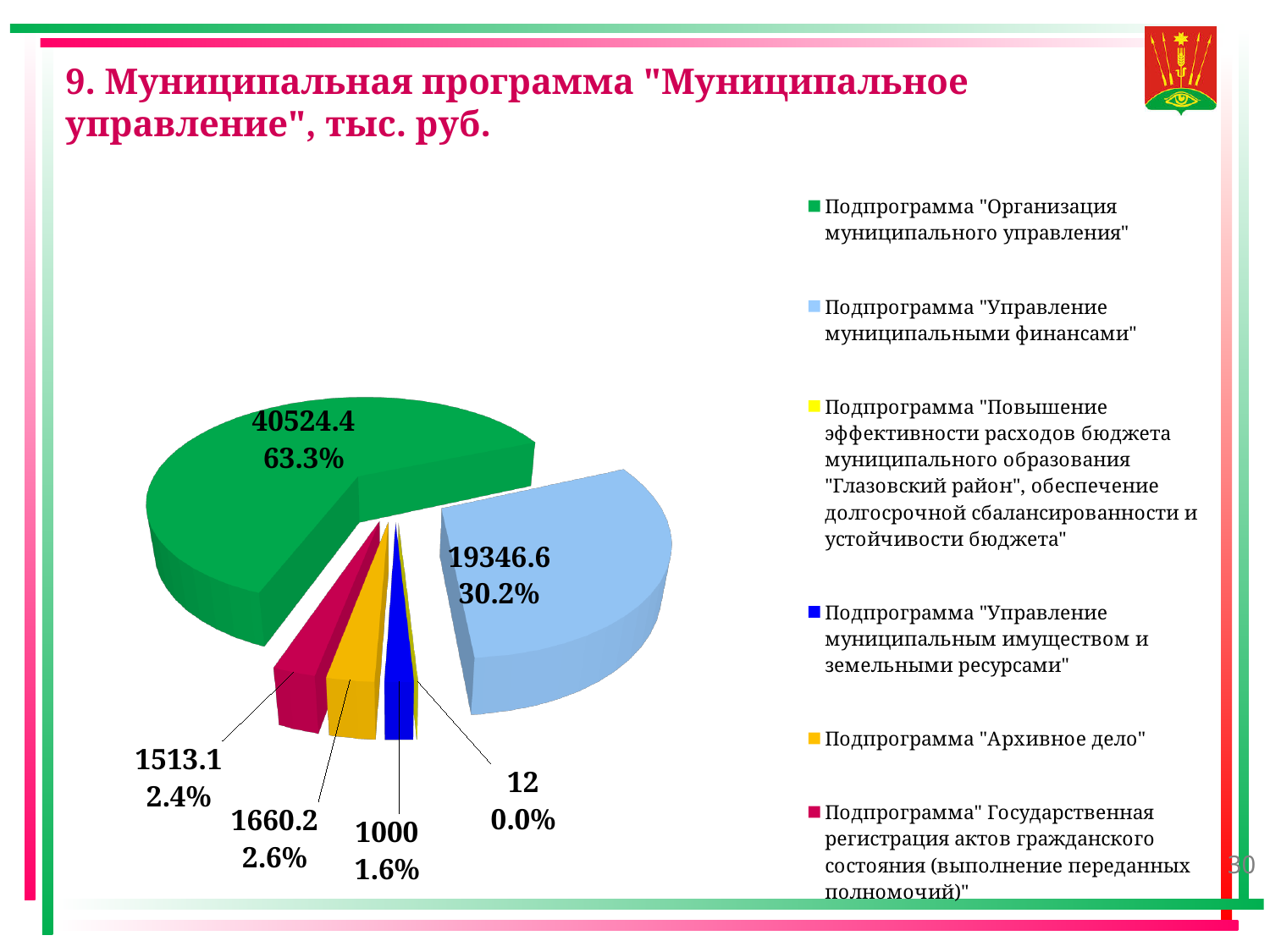
How many slices does the pie chart have? 6 Which subprogram has the smallest slice of the pie? Подпрограмма "Повышение эффективности расходов бюджета муниципального образования "Глазовский район", обеспечение долгосрочной сбалансированности и устойчивости бюджета" What is the difference between the values for "Организация муниципального управления" and "Управление муниципальными финансами"? 21177.8 What is the value for the subprogram "Организация муниципального управления"? 40524.4 What is the value for the subprogram "Архивное дело"? 1660.2 What is the value for the subprogram "Управление муниципальными финансами"? 19346.6 Which subprogram has the largest slice of the pie? Подпрограмма "Организация муниципального управления" What share of the pie does the subprogram "Управление муниципальным имуществом и земельными ресурсами" have? 1.6% What share of the pie does the subprogram "Государственная регистрация актов гражданского состояния" have? 2.4% How many entries does the legend list? 6 Which is larger: the value for "Архивное дело" or the value for "Государственная регистрация актов гражданского состояния"? Подпрограмма "Архивное дело" What kind of chart is shown on the slide? Pie chart